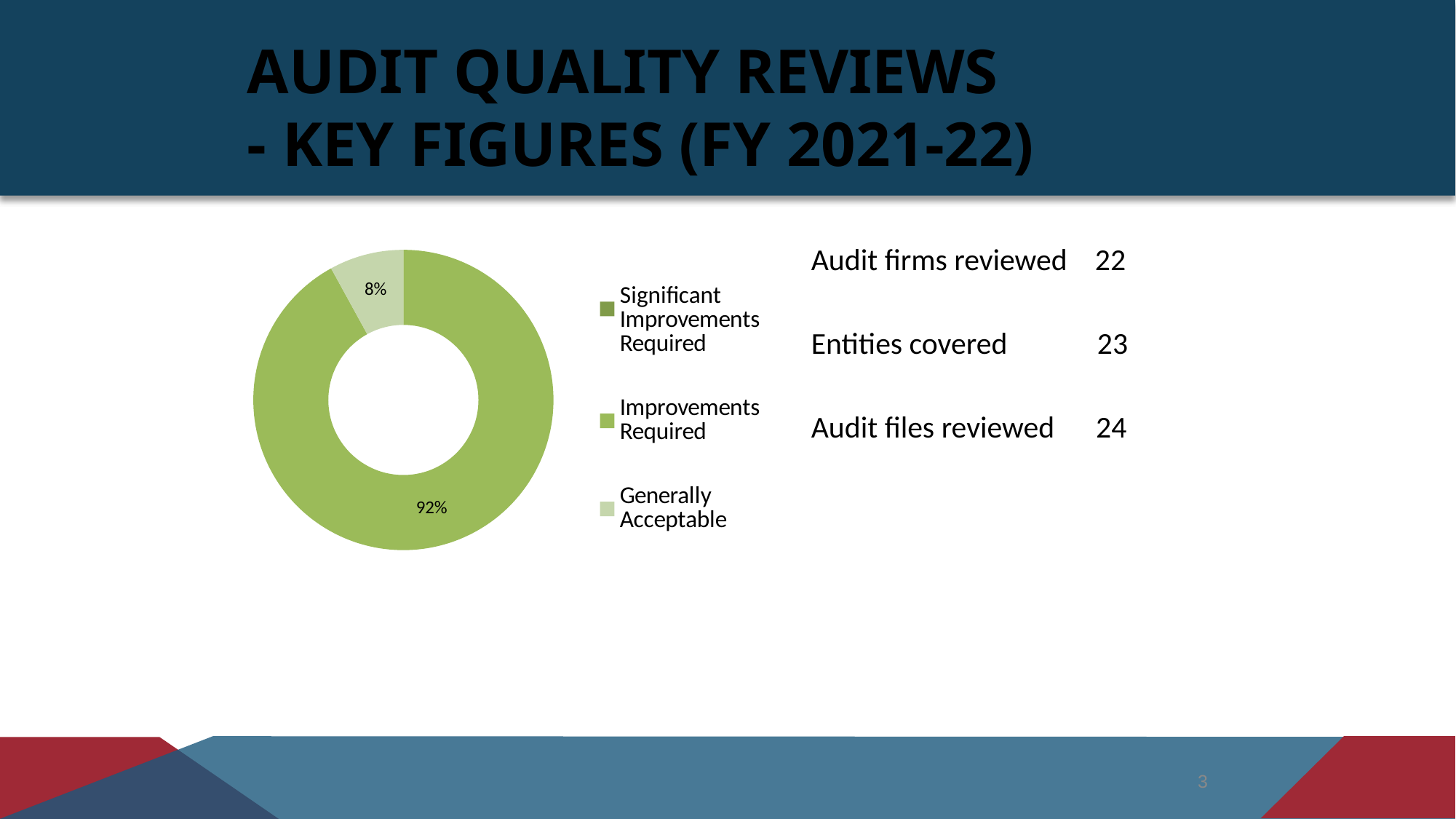
Which is larger in the doughnut chart: Improvements Required or Generally Acceptable? Improvements Required What is the difference in percentage points between the 92% slice and the 8% slice? 84 percentage points What kind of chart is shown on the slide? Doughnut (pie) chart Which labelled slice in the doughnut chart is the smallest? Generally Acceptable What share of the doughnut chart is labelled for Improvements Required? 92% Which legend entry is shown with the lightest green colour? Generally Acceptable How many entries does the legend of the doughnut chart list? 3 How many slices with data labels are visible in the doughnut chart? 2 What share of the doughnut chart is labelled for Generally Acceptable? 8% Is the share for Improvements Required greater or less than 50%? greater Which category has the largest slice in the doughnut chart? Improvements Required What is the title of the slide containing the chart? AUDIT QUALITY REVIEWS - KEY FIGURES (FY 2021-22)